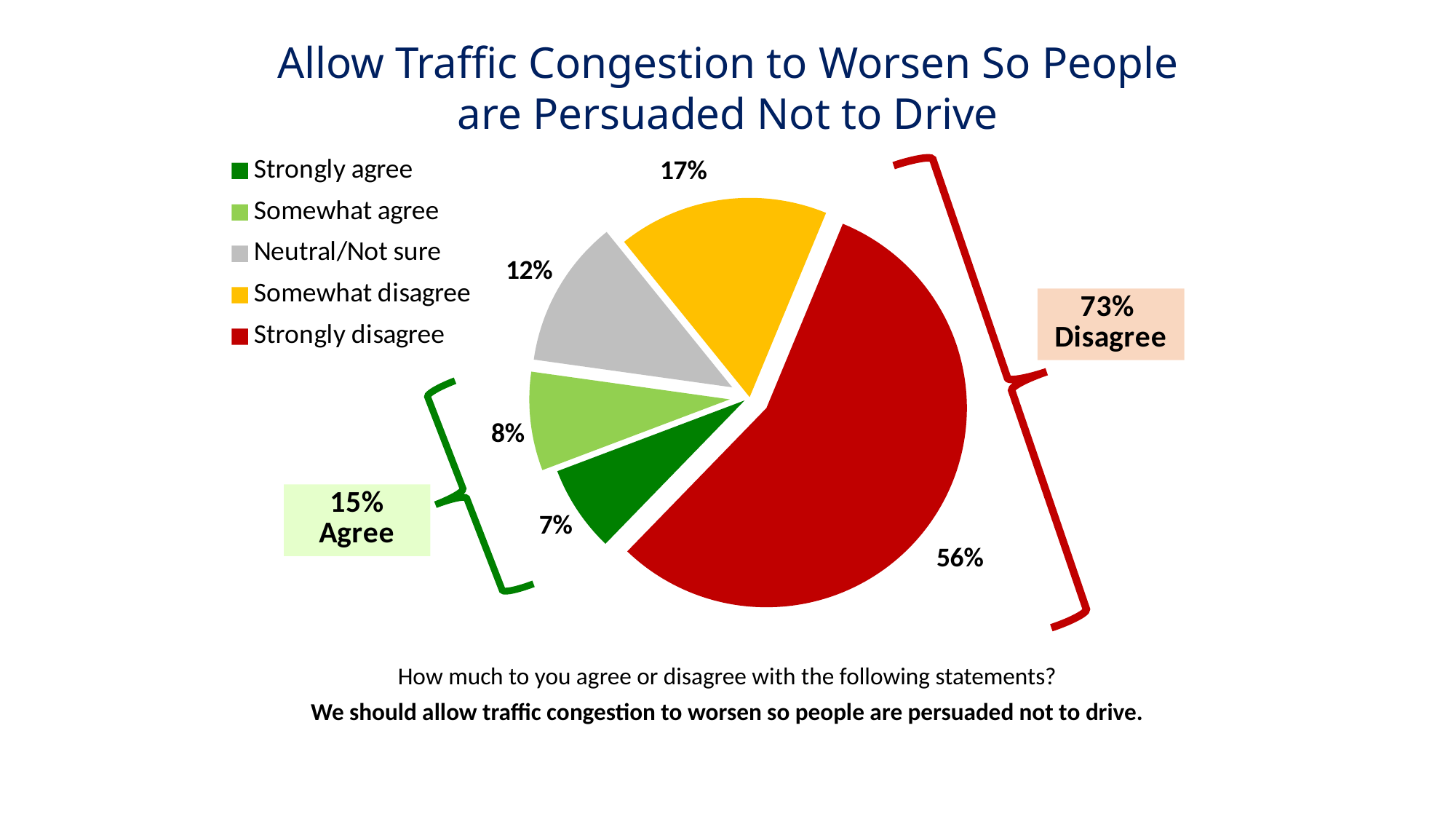
Which response category has the largest share of the pie? Strongly disagree What is the difference between the Strongly disagree and Somewhat disagree shares? 39% What colour is the Somewhat disagree slice? Yellow What kind of chart is shown on the slide? Pie chart What percentage of respondents strongly agree? 7% What percentage of respondents are neutral or not sure? 12% What percentage of respondents somewhat disagree? 17% What percentage of respondents strongly disagree? 56% Which is larger, the Somewhat agree slice or the Neutral/Not sure slice? Neutral/Not sure What combined percentage is shown for respondents who disagree? 73% How many slices does the pie chart have? 5 Which response category has the smallest share of the pie? Strongly agree